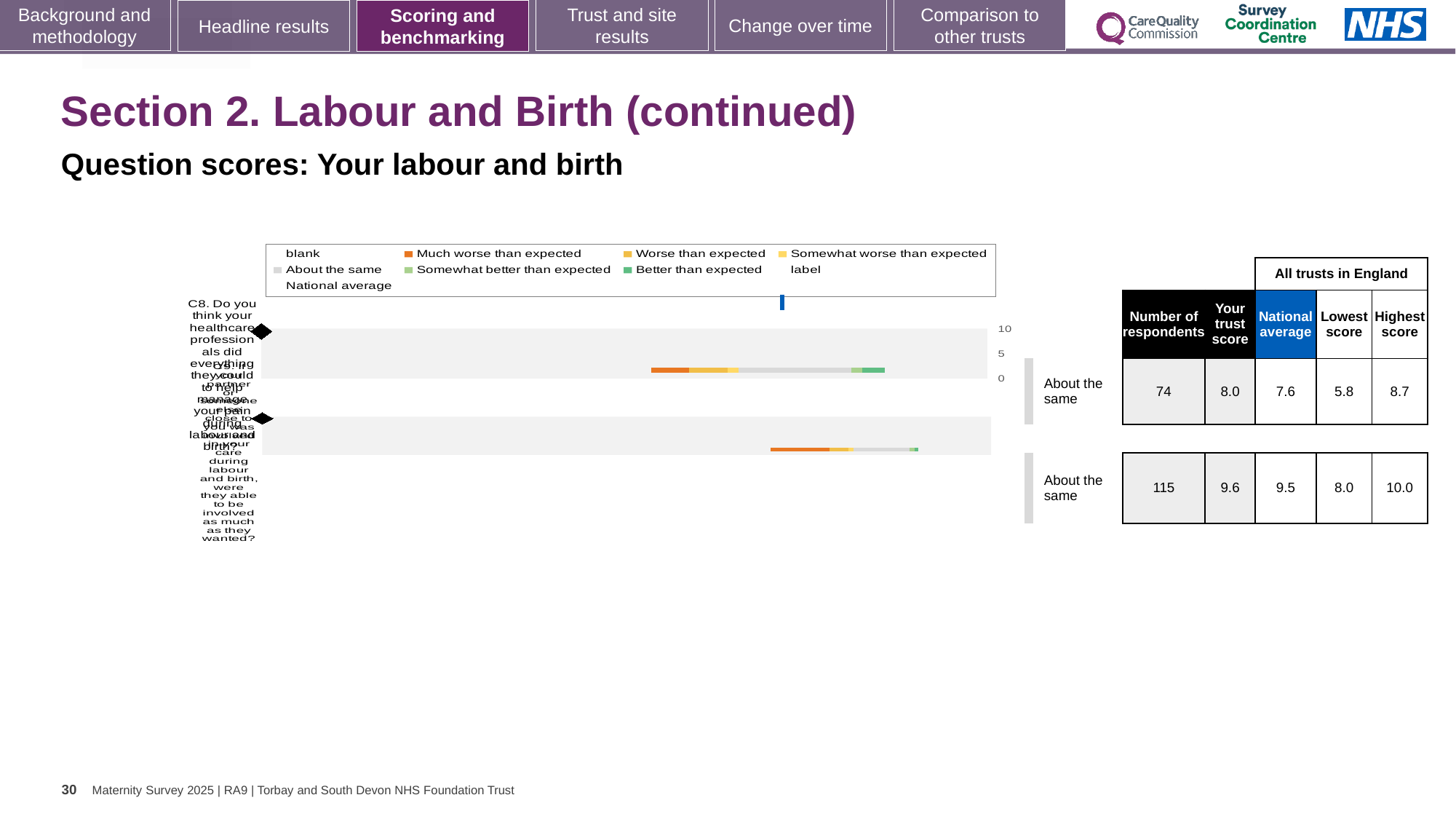
In the table next to the chart, what is 'Your trust score' for the first (top) row, question C8? 8.0 What colour does the legend use for 'Much worse than expected'? orange In the table next to the chart, what is the lowest score for the first (top) row, question C8? 5.8 In the table next to the chart, what is the national average for the second (bottom) row? 9.5 Which row has the higher 'Your trust score', the first (top) row or the second (bottom) row? second (bottom) row For the first (top) row, how much higher is 'Your trust score' (8.0) than the national average (7.6)? 0.4 In the table next to the chart, what is the highest score for the second (bottom) row? 10.0 How many question rows (bars) does the chart show? 2 What benchmark category label is shown beside both rows of the chart? About the same What kind of chart is shown on the slide? bar chart For the first (top) row, what is the difference between the highest score (8.7) and the lowest score (5.8)? 2.9 In the table next to the chart, what is the number of respondents for the first (top) row, question C8? 74